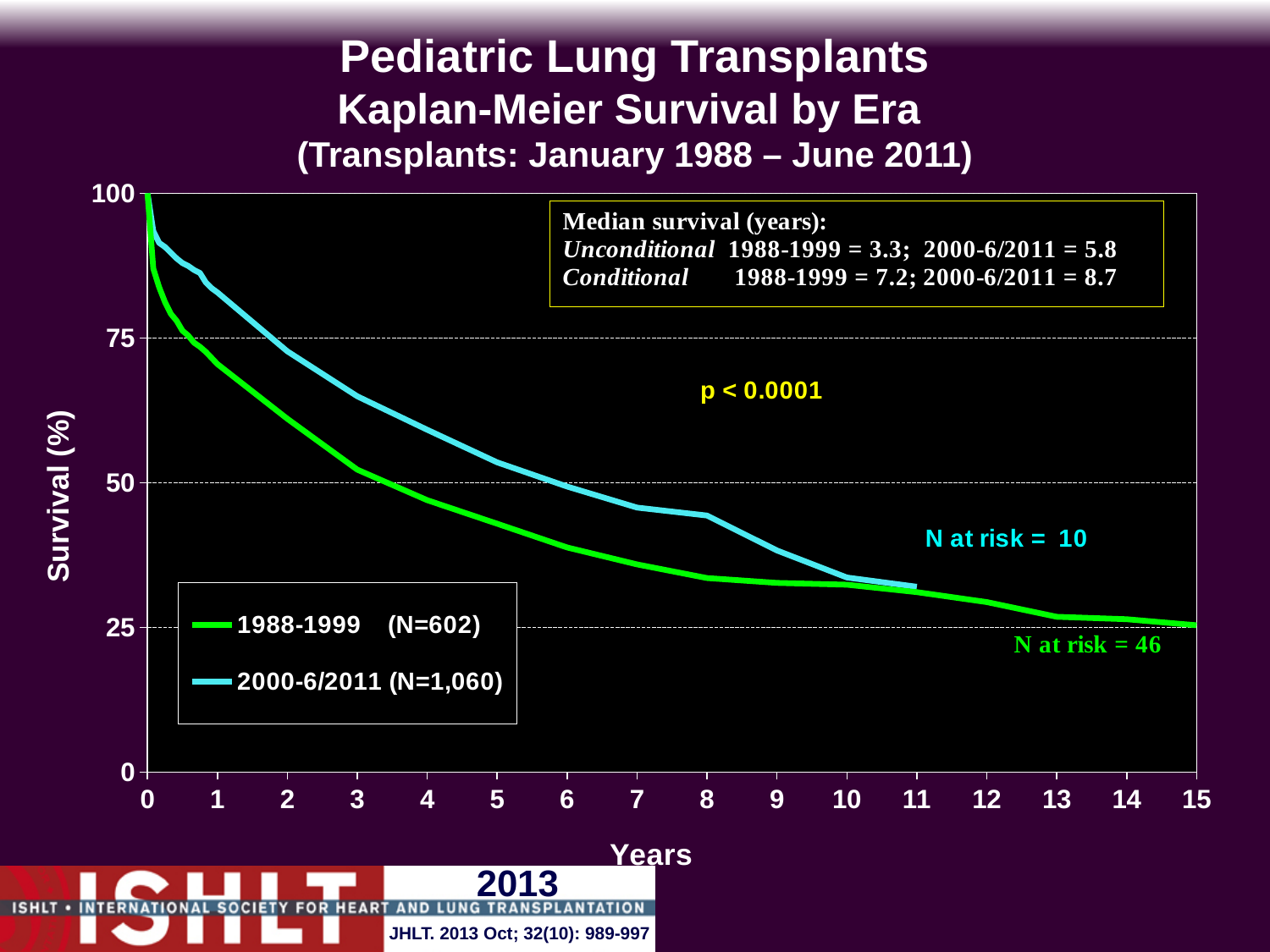
Is the survival for the 1988-1999 era at 5 years greater or less than 50? less What is the N for the 2000-6/2011 era shown in the legend? 1,060 How many series does the legend list? 2 Is the survival for the 2000-6/2011 era at 5 years greater or less than 50? greater What kind of chart is shown on the slide? line chart What is the difference in unconditional median survival (years) between the 2000-6/2011 era and the 1988-1999 era? 2.5 What is the N at risk shown for the 2000-6/2011 curve? 10 What is the N for the 1988-1999 era shown in the legend? 602 What is the unconditional median survival in years for the 2000-6/2011 era? 5.8 What is the conditional median survival in years for the 1988-1999 era? 7.2 Do the survival curves rise or fall as years increase? fall At 5 years, which era has the higher survival? 2000-6/2011